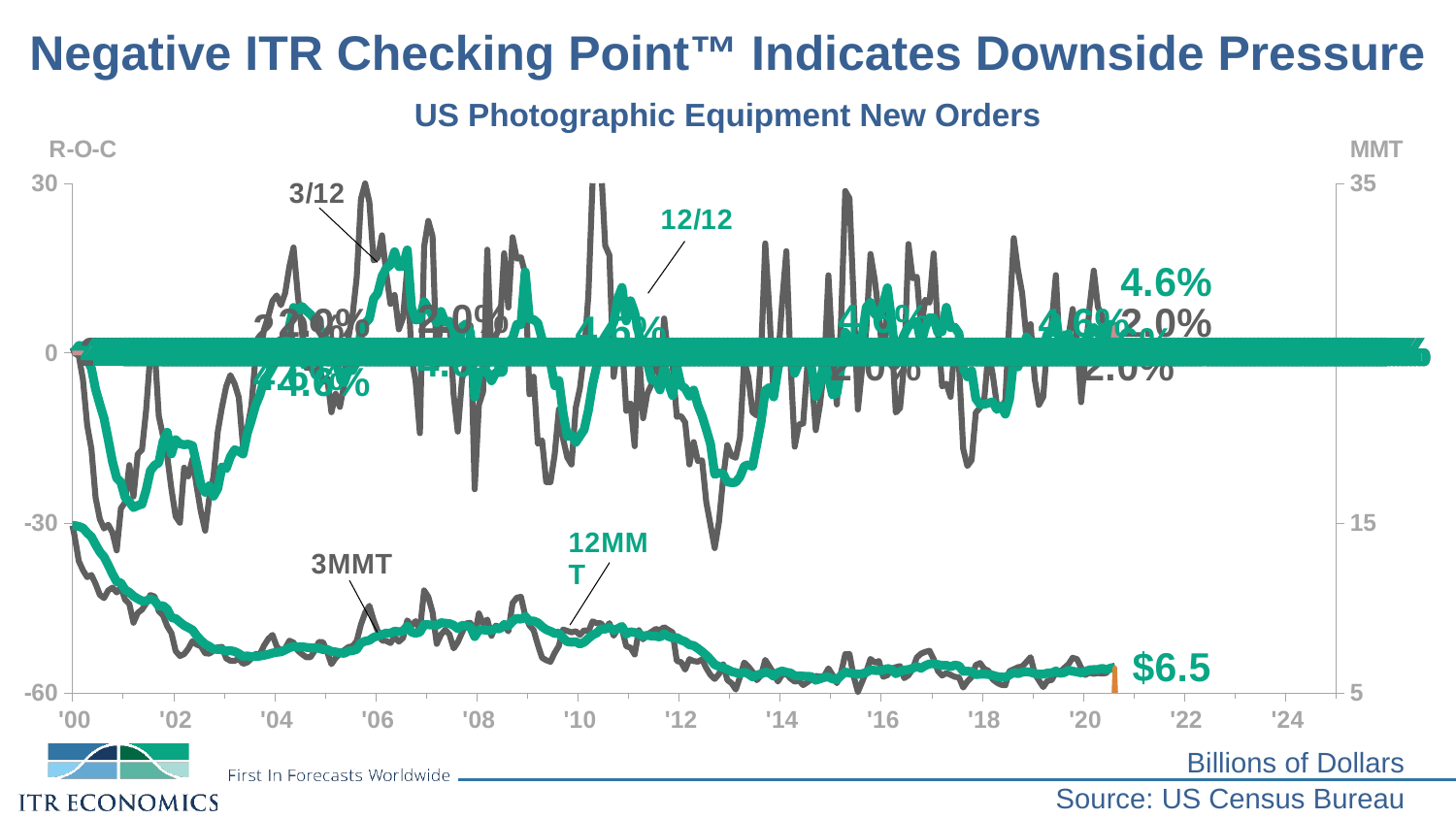
Is the 12MMT value at '10 greater or less than 5 on the MMT axis? greater What is the latest value labeled for the 12/12 rate-of-change line? 4.6% What is the highest value shown on the left R-O-C axis? 30 Is the 12MMT value at '10 greater or less than 15 on the MMT axis? less What is the latest value labeled for the 12MMT line? $6.5 What kind of chart is shown on the slide? line chart Does the 12MMT line rise or fall from '00 to '20? fall What is the title of the chart? US Photographic Equipment New Orders Is the 12/12 value at '01 greater or less than 0 on the R-O-C axis? less